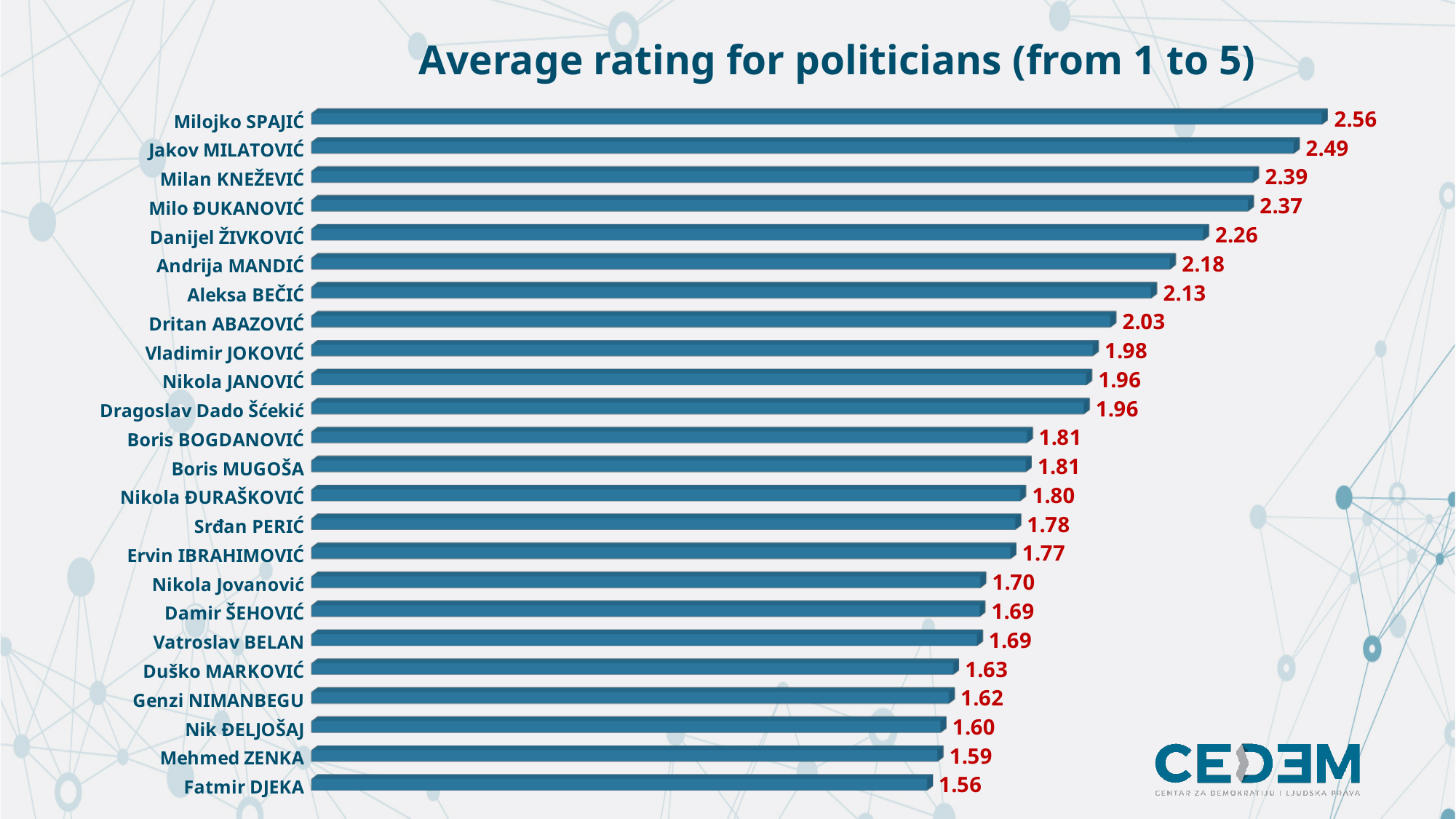
What is the average rating for Milojko SPAJIĆ? 2.56 What is the average rating for Fatmir DJEKA? 1.56 Which politician has the lowest average rating? Fatmir DJEKA How many politicians are shown in the chart? 24 Who has a higher average rating, Aleksa BEČIĆ or Vladimir JOKOVIĆ? Aleksa BEČIĆ What type of chart is shown on the slide? Bar chart Which politician has the highest average rating? Milojko SPAJIĆ What is the difference between the average ratings of Milo ĐUKANOVIĆ and Fatmir DJEKA? 0.81 What is the difference between the average ratings of Milojko SPAJIĆ and Jakov MILATOVIĆ? 0.07 What is the average rating for Andrija MANDIĆ? 2.18 What is the title of the chart? Average rating for politicians (from 1 to 5) What is the average rating for Dritan ABAZOVIĆ? 2.03